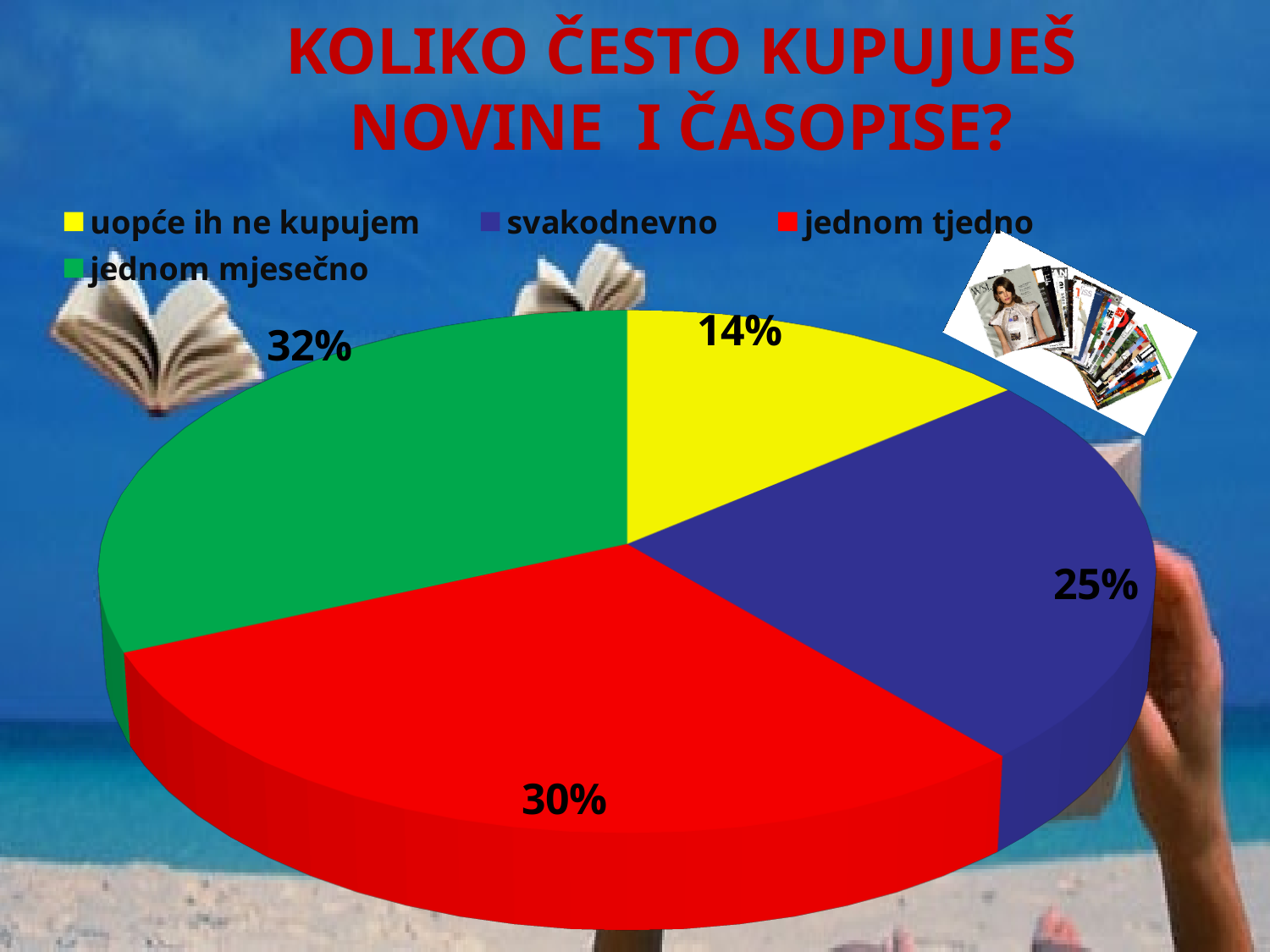
What colour is the slice for 'jednom tjedno'? red What is the difference in percentage points between 'jednom mjesečno' and 'uopće ih ne kupujem'? 18 Which category has the largest share of the pie? jednom mjesečno What kind of chart is shown on the slide? pie chart Which category has the smallest share of the pie? uopće ih ne kupujem What percentage of the pie is 'jednom mjesečno'? 32% What is the title of the chart? KOLIKO ČESTO KUPUJUEŠ NOVINE I ČASOPISE? What percentage of the pie is 'svakodnevno'? 25% How many categories does the pie chart have? 4 What percentage of the pie is 'uopće ih ne kupujem'? 14% What percentage of the pie is 'jednom tjedno'? 30% Which is larger: the share for 'svakodnevno' or the share for 'jednom tjedno'? jednom tjedno